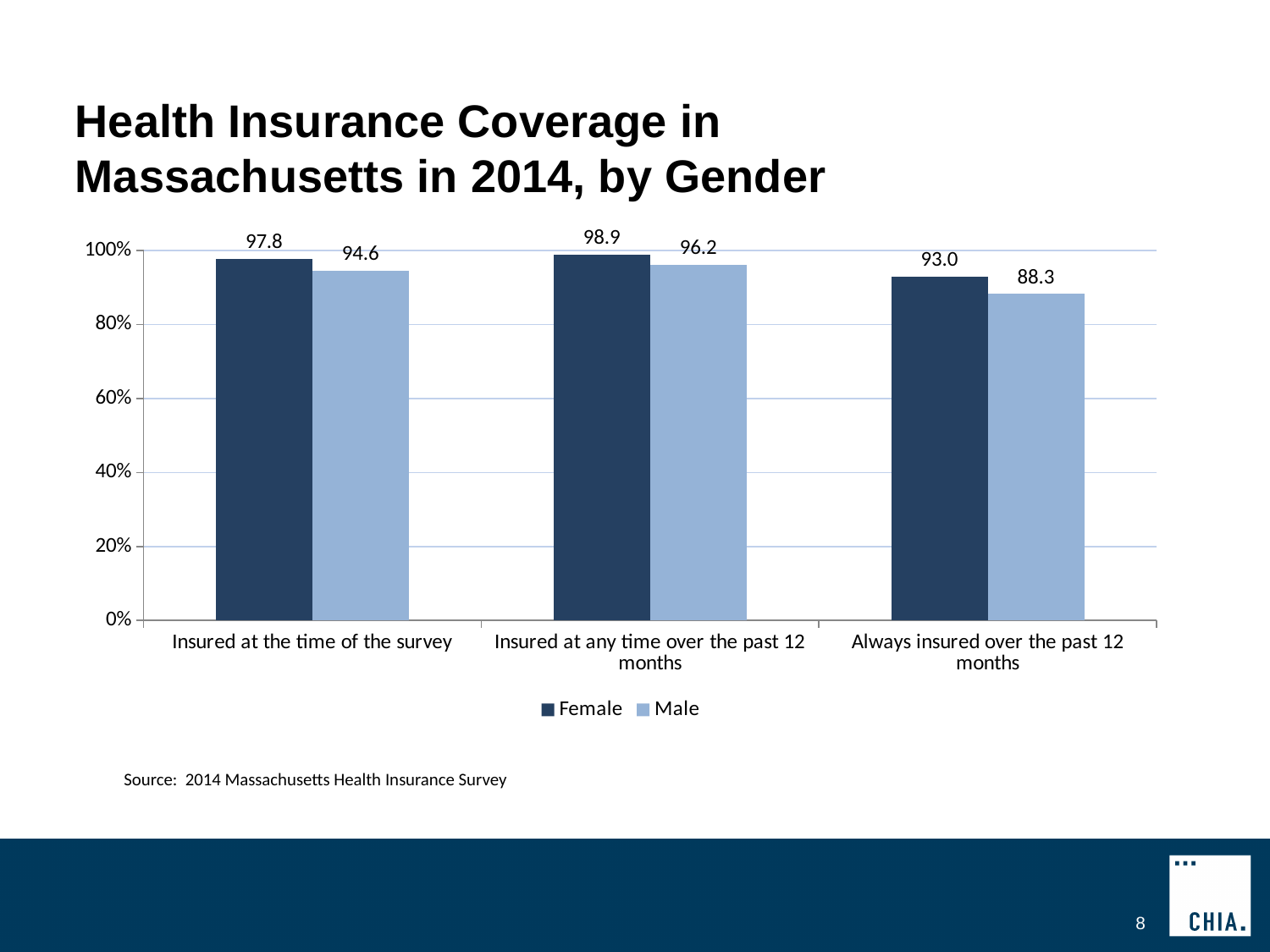
What kind of chart is shown on the slide? Bar chart Which is larger for "Insured at the time of the survey": the Female value or the Male value? Female What is the Male value for "Always insured over the past 12 months"? 88.3 What is the Male value for "Insured at any time over the past 12 months"? 96.2 Which category has the highest Female value? Insured at any time over the past 12 months Is the Male value for "Always insured over the past 12 months" greater or less than 80%? greater How many categories are shown on the x axis? 3 What is the Female value for "Insured at the time of the survey"? 97.8 How many series does the legend list? 2 Which category has the lowest Male value? Always insured over the past 12 months What are the two series listed in the legend? Female and Male What is the difference between the Female and Male values for "Always insured over the past 12 months"? 4.7